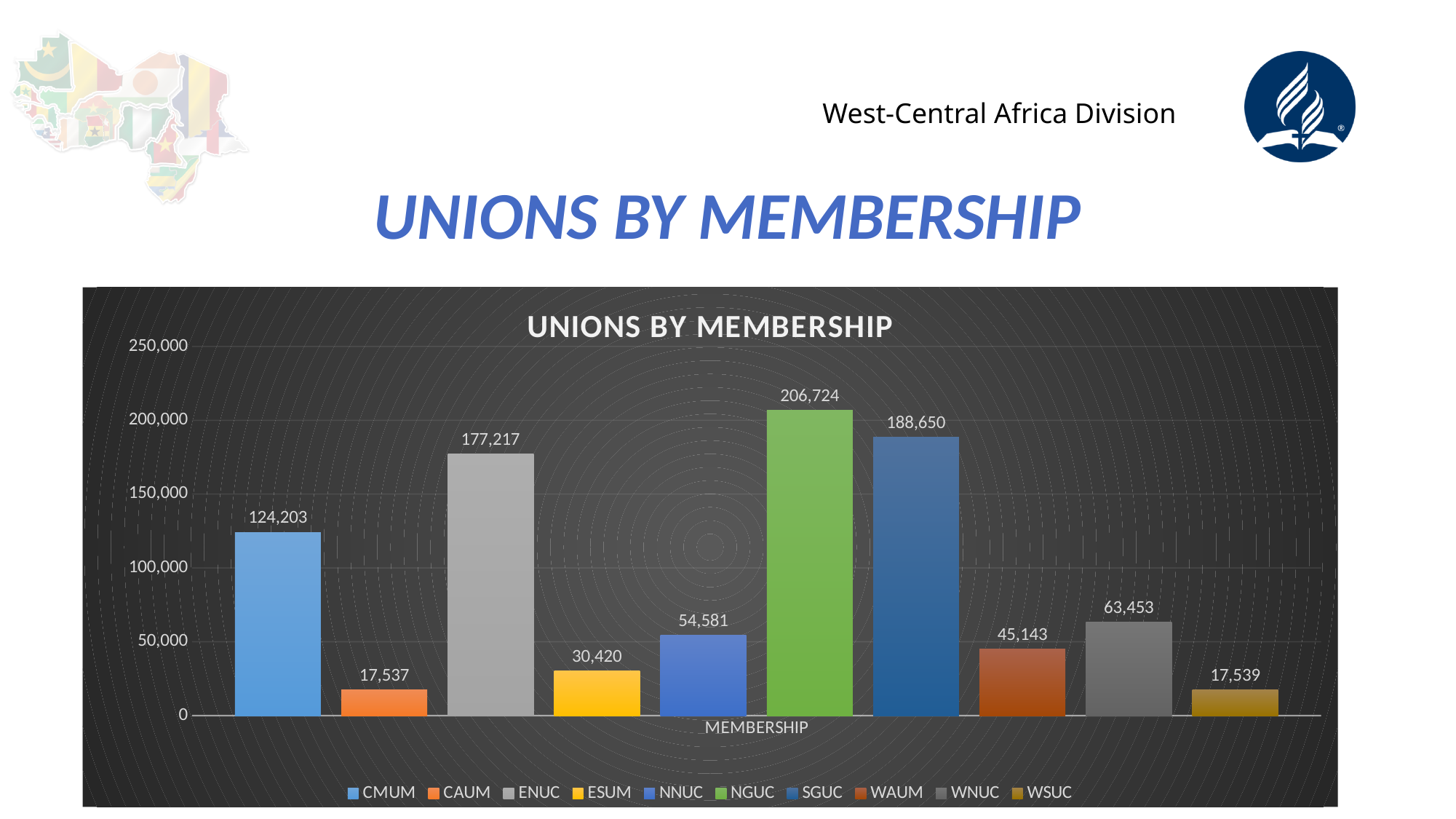
What is the membership value for CMUM? 124,203 Which has a larger membership, WNUC or NNUC? WNUC What kind of chart is shown on the slide? bar chart Which union has the highest membership? NGUC Which union has the lowest membership? CAUM What is the title of the chart? UNIONS BY MEMBERSHIP What is the difference in membership between NGUC and SGUC? 18,074 How many unions are shown in the chart? 10 Is the membership value for ESUM greater or less than 50,000? less What is the difference in membership between ENUC and CMUM? 53,014 What is the membership value for WAUM? 45,143 What is the membership value for NGUC? 206,724